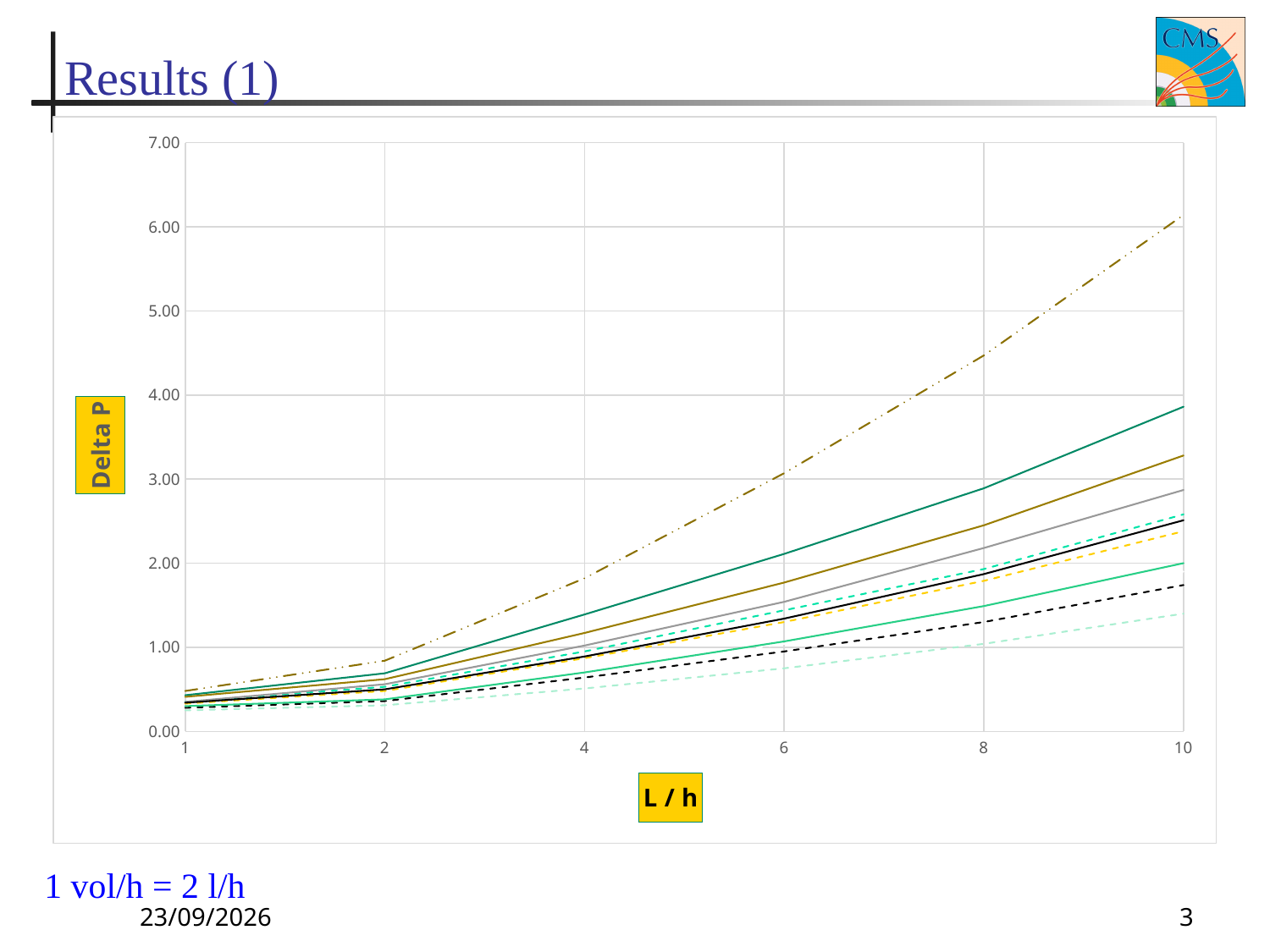
Is the value of the highest line at L / h = 2 greater or less than 1.00? less Are all the lines at L / h = 1 greater or less than 1.00? less What is the maximum value shown on the Delta P axis? 7.00 What kind of chart is shown on the slide? line chart Is the value of the highest line at L / h = 10 greater or less than 5.00? greater At L / h = 10, which line style reaches the highest Delta P: the dash-dot line or the solid lines? the dash-dot line What is the label of the vertical axis of the chart? Delta P Do the plotted lines rise or fall as L / h increases from 1 to 10? rise What is the label of the horizontal axis of the chart? L / h